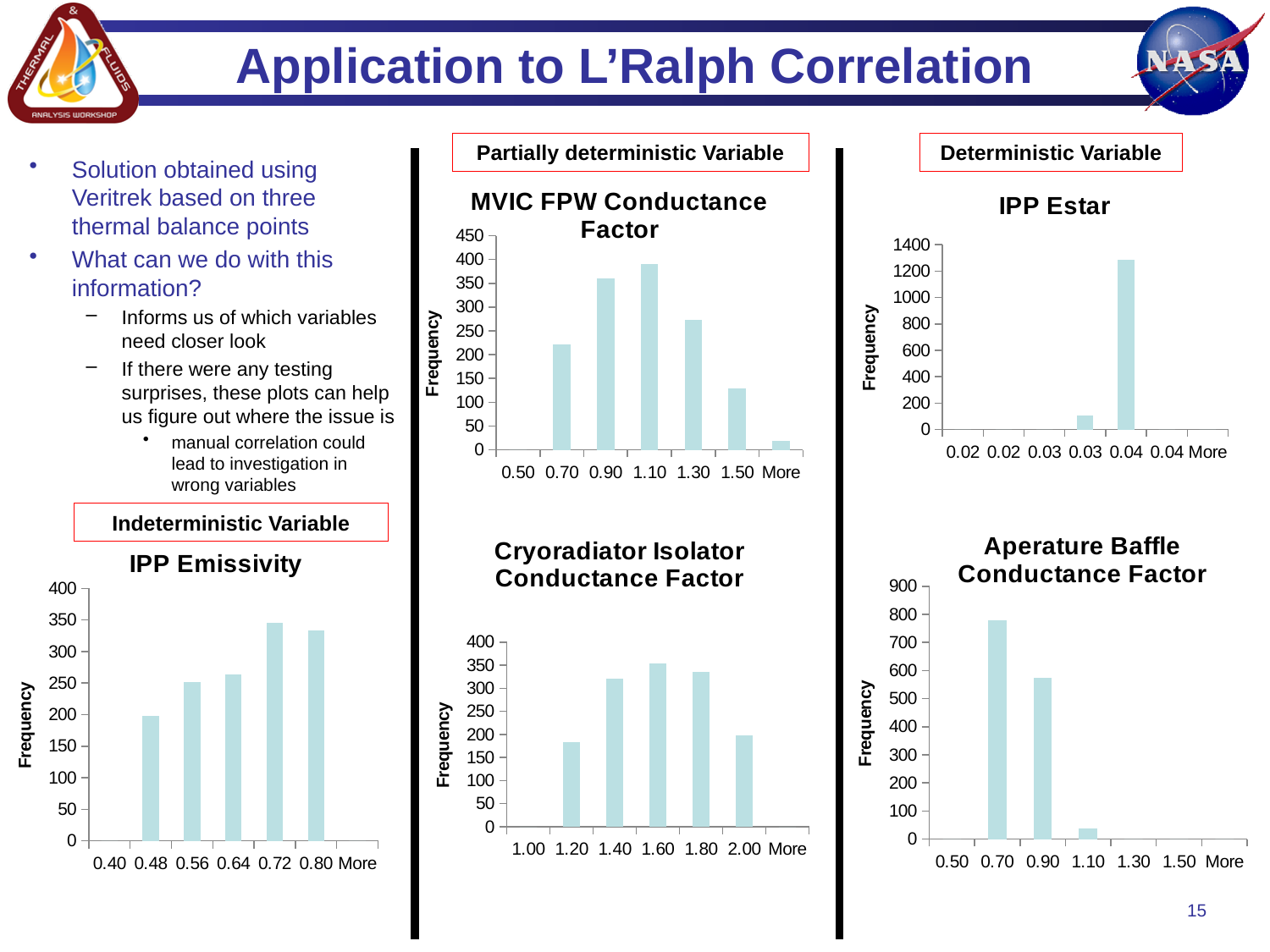
In the Aperature Baffle Conductance Factor chart, do the values rise or fall from 0.70 to 1.10? fall In the Cryoradiator Isolator Conductance Factor chart, which is larger, the value for 1.20 or the value for 1.40? 1.40 In the IPP Emissivity chart, is the value for 0.72 greater or less than 300? greater In the IPP Emissivity chart, which is larger, the value for 0.48 or the value for 0.56? 0.56 In the Aperature Baffle Conductance Factor chart, which bin has the highest frequency? 0.70 In the MVIC FPW Conductance Factor chart, is the value for 1.50 greater or less than 150? less In the MVIC FPW Conductance Factor chart, which bin has the highest frequency? 1.10 In the IPP Estar chart, is the tallest bar greater or less than 1000? greater In the IPP Emissivity chart, which bin has the lowest frequency among the plotted bars? 0.48 What kind of chart is the MVIC FPW Conductance Factor chart? bar chart